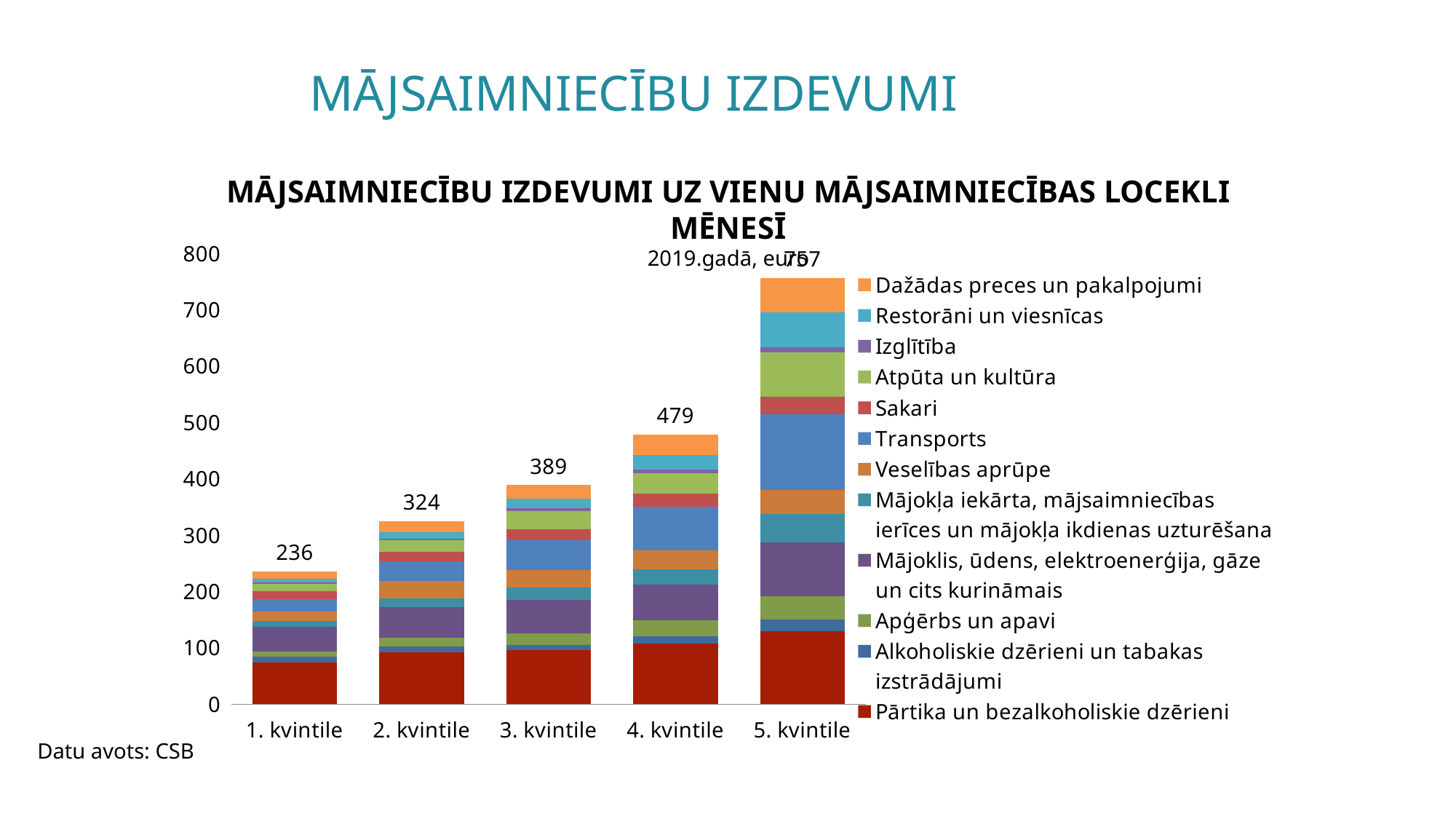
How many expenditure categories does the legend list? 12 Which quintile has the lowest total expenditure? 1. kvintile Is the Pārtika un bezalkoholiskie dzērieni segment for 5. kvintile greater or less than 100? greater What is the total value shown above the bar for 1. kvintile? 236 How many quintile categories are shown on the x axis? 5 Which is larger, the total for 2. kvintile or the total for 3. kvintile? 3. kvintile What is the difference between the total for 4. kvintile and the total for 2. kvintile? 155 What kind of chart is shown on the slide? Stacked bar chart What is the total value shown above the bar for 3. kvintile? 389 Which quintile has the highest total expenditure? 5. kvintile Do the total expenditures rise or fall from 1. kvintile to 5. kvintile? Rise What is the total value shown above the bar for 4. kvintile? 479